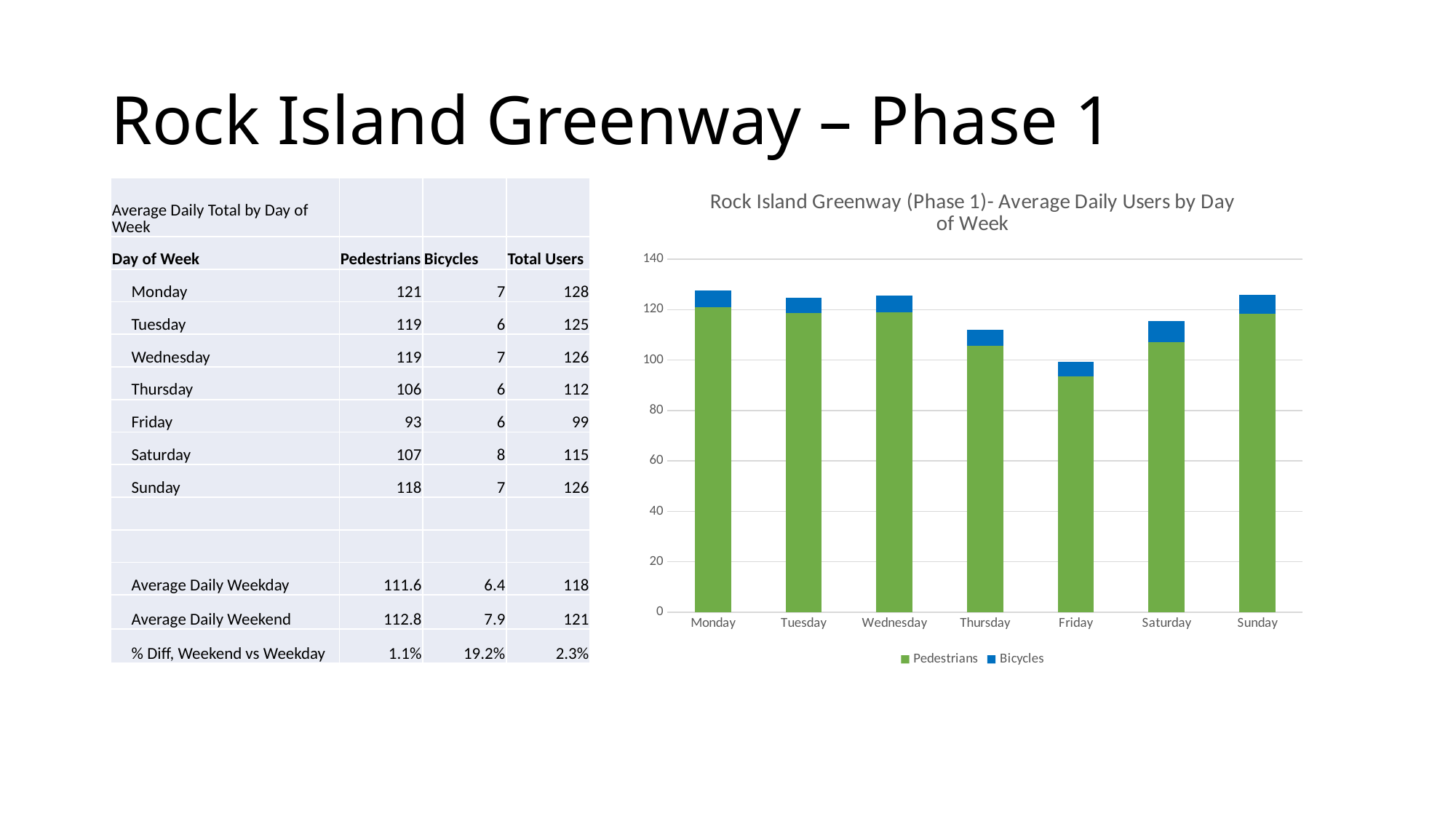
How many days of the week are plotted on the x axis of the chart? 7 Which day has the highest total bar in the chart? Monday Is the total bar for Friday greater or less than 100? less What is the difference in Pedestrians between Monday and Friday? 28 Which day has the lowest total bar in the chart? Friday Which colour represents Bicycles in the chart? Blue What kind of chart is shown on the slide? Stacked bar chart What is the total number of average daily users for Friday? 99 How many series does the chart legend list? 2 Which is larger, the Pedestrians value for Saturday or for Thursday? Saturday What is the Bicycles value for Saturday? 8 What is the Pedestrians value for Thursday? 106